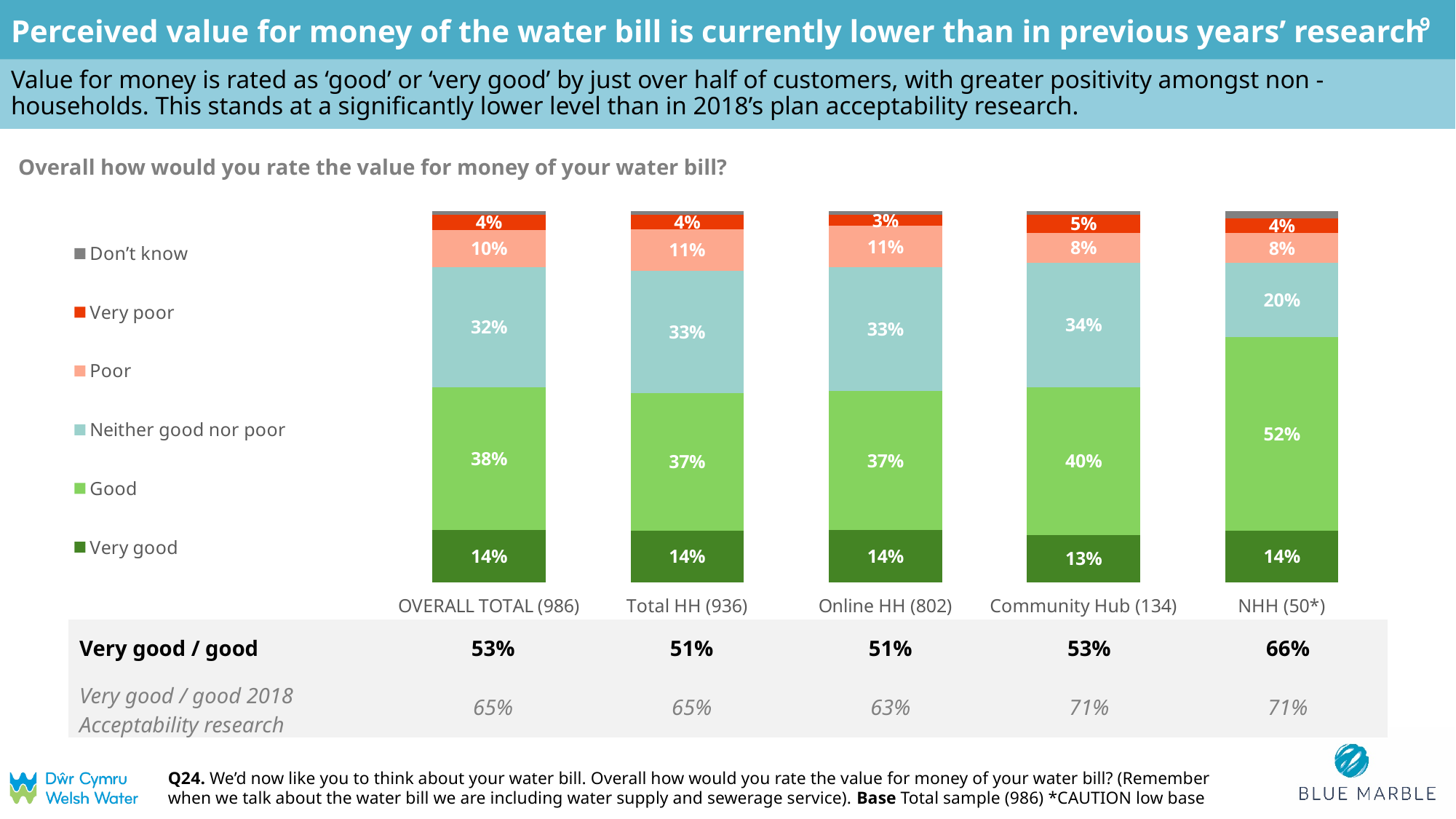
Which legend entry is shown in dark green? Very good Which group has the highest 'Good' percentage? NHH (50*) What type of chart is shown on the slide? Stacked bar chart What is the 'Very good' value for Community Hub (134)? 13% What percentage of NHH (50*) customers rated value for money as 'Good'? 52% How many percentage points higher is the 'Good' value for NHH (50*) than for OVERALL TOTAL (986)? 14 percentage points What is the 'Neither good nor poor' value for Community Hub (134)? 34% Which has a larger 'Poor' value: Total HH (936) or Community Hub (134)? Total HH (936) Which group has the lowest 'Neither good nor poor' percentage? NHH (50*) How many series does the legend list? 6 What is the 'Very poor' value for Online HH (802)? 3% How many groups (bars) are shown in the chart? 5